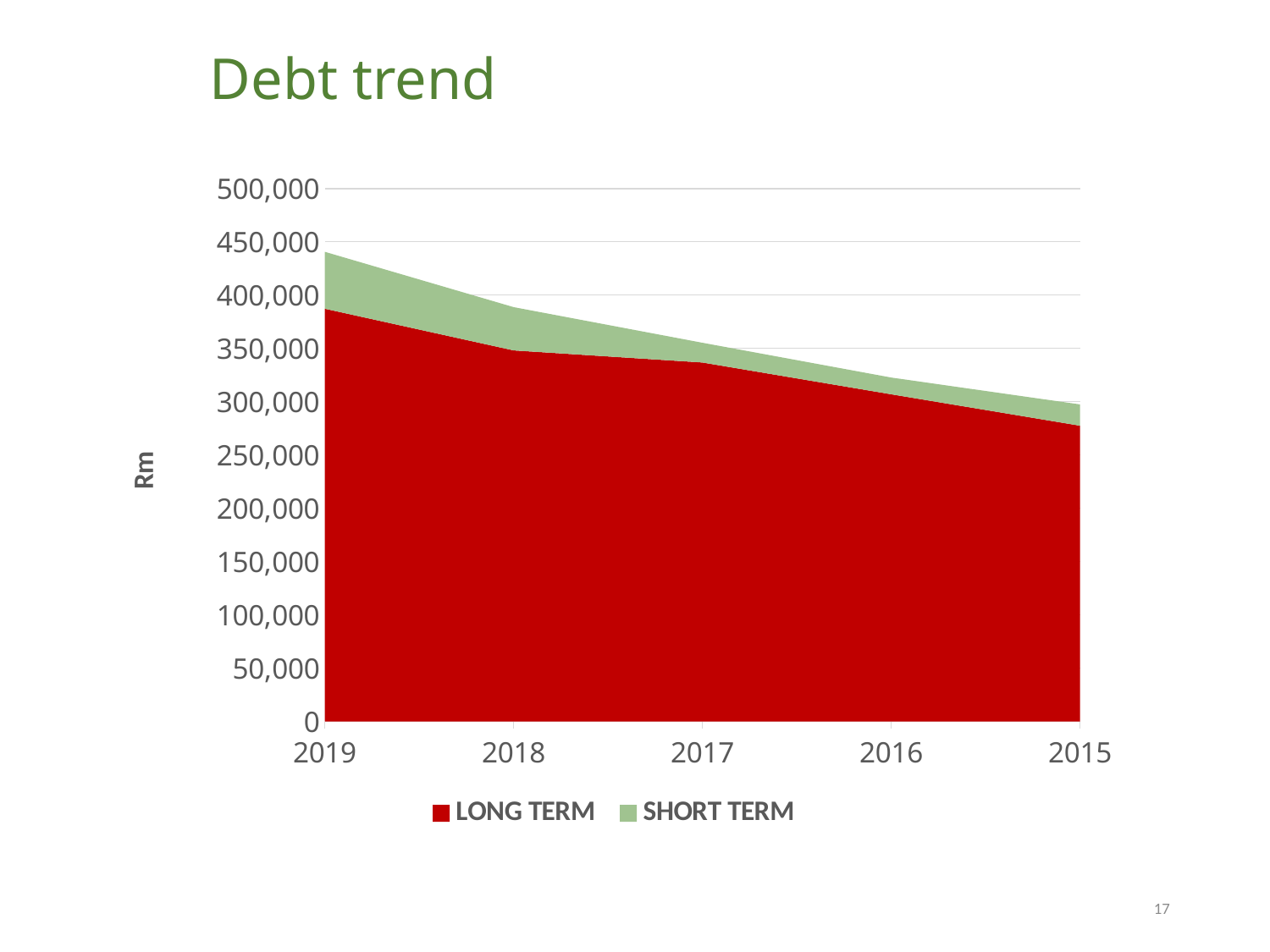
Is the total debt for 2015 greater or less than 350,000? less How many years are shown along the x axis? 5 What is the label on the vertical axis? Rm Which year has the lowest total debt? 2015 Which year has the highest total debt? 2019 Is the LONG TERM value for 2019 greater or less than 350,000? greater What kind of chart is shown on the slide? Stacked area chart Is the total debt (LONG TERM plus SHORT TERM) for 2019 greater or less than 400,000? greater How many series does the legend list? 2 What is the title of the chart? Debt trend Moving from left to right along the x axis (2019 to 2015), does total debt rise or fall? fall